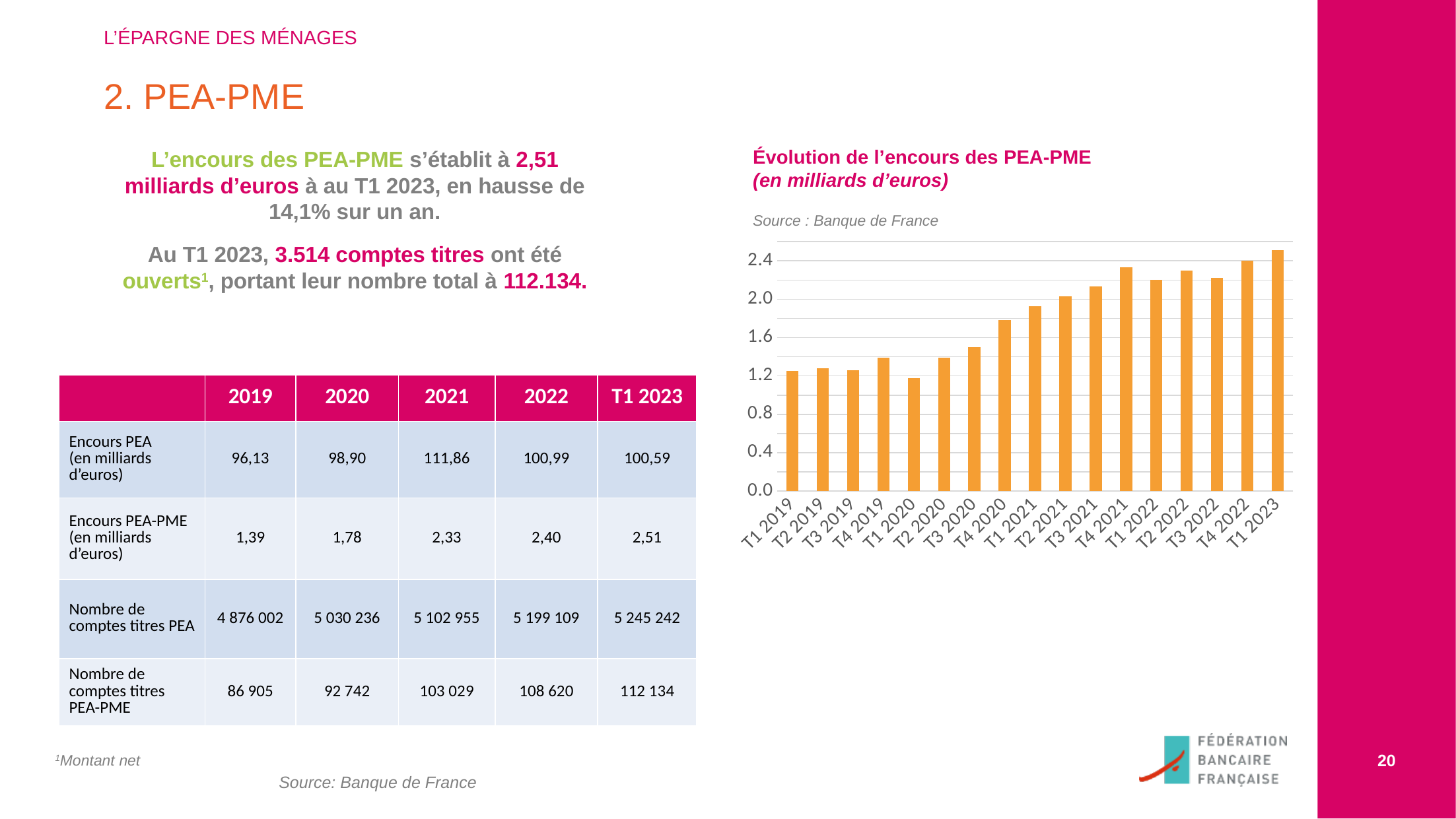
How many quarterly bars are plotted in the chart? 17 Overall, do the values rise or fall from T1 2019 to T1 2023? Rise Which is larger, the value for T4 2019 or the value for T4 2020? T4 2020 Is the value for T3 2020 greater or less than 1.6? less Is the value for T4 2020 greater or less than 1.6? greater Is the value for T1 2023 greater or less than 2.4? greater What source is cited for the chart? Banque de France What is the title of the chart? Évolution de l'encours des PEA-PME (en milliards d'euros) Which quarter has the lowest bar in the chart? T1 2020 What kind of chart is shown on the slide? Bar chart Which quarter has the highest bar in the chart? T1 2023